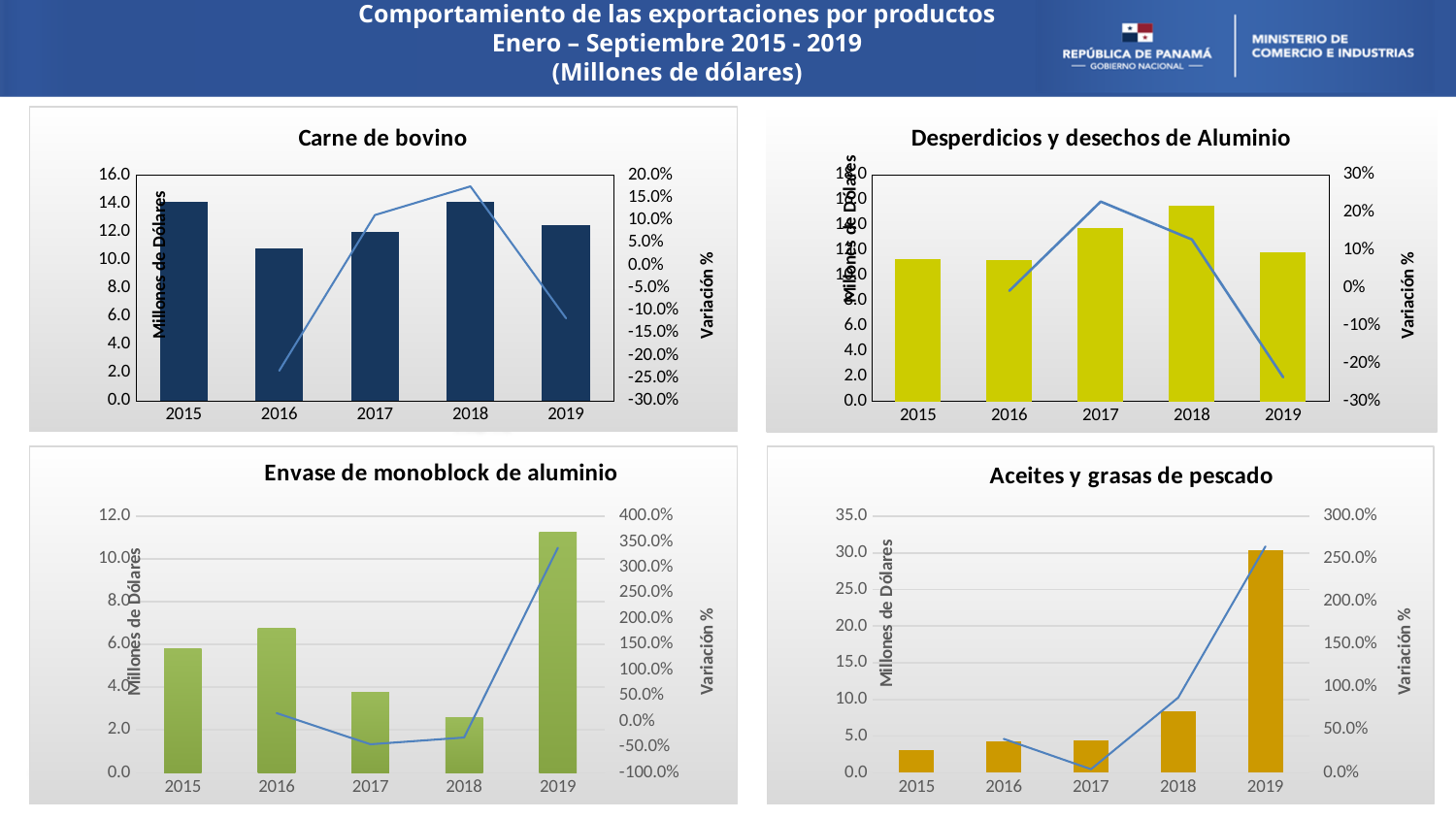
In the 'Carne de bovino' chart, is the bar value for 2016 greater or less than 12.0? less In the 'Aceites y grasas de pescado' chart, which year has the highest bar? 2019 In the 'Envase de monoblock de aluminio' chart, which year has the highest bar? 2019 In the 'Desperdicios y desechos de Aluminio' chart, is the bar value for 2018 greater or less than 14.0? greater In the 'Aceites y grasas de pescado' chart, do the bar values rise or fall from 2017 to 2019? rise In the 'Envase de monoblock de aluminio' chart, which year has the lowest bar? 2018 In the 'Aceites y grasas de pescado' chart, is the bar value for 2019 greater or less than 25.0? greater In the 'Desperdicios y desechos de Aluminio' chart, which year has the highest bar? 2018 How many years are shown on the x axis of the 'Carne de bovino' chart? 5 In the 'Carne de bovino' chart, which year has the lowest bar? 2016 In the 'Aceites y grasas de pescado' chart, which year has the larger bar, 2016 or 2018? 2018